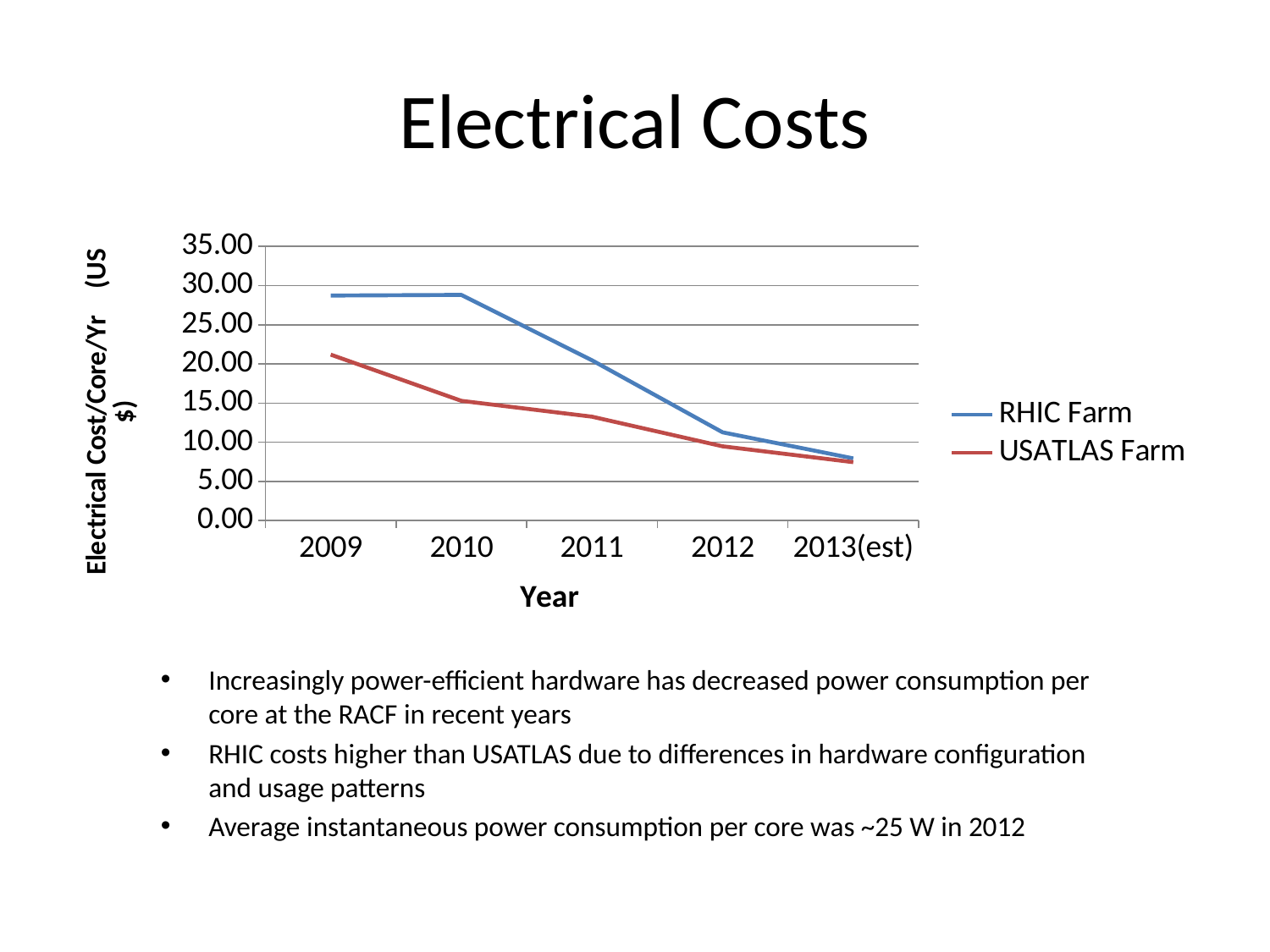
Is the value for USATLAS Farm in 2013(est) greater or less than 10.00? less How many series does the legend list? 2 How many years are plotted along the x axis? 5 Is the value for RHIC Farm in 2009 greater or less than 25.00? greater Is the value for RHIC Farm in 2012 greater or less than 15.00? less Do the USATLAS Farm values rise or fall from 2009 to 2013(est)? fall In which year is the RHIC Farm value lowest? 2013(est) In which year is the USATLAS Farm value highest? 2009 What kind of chart is shown on the slide? line chart In 2011, which series has the higher value, RHIC Farm or USATLAS Farm? RHIC Farm